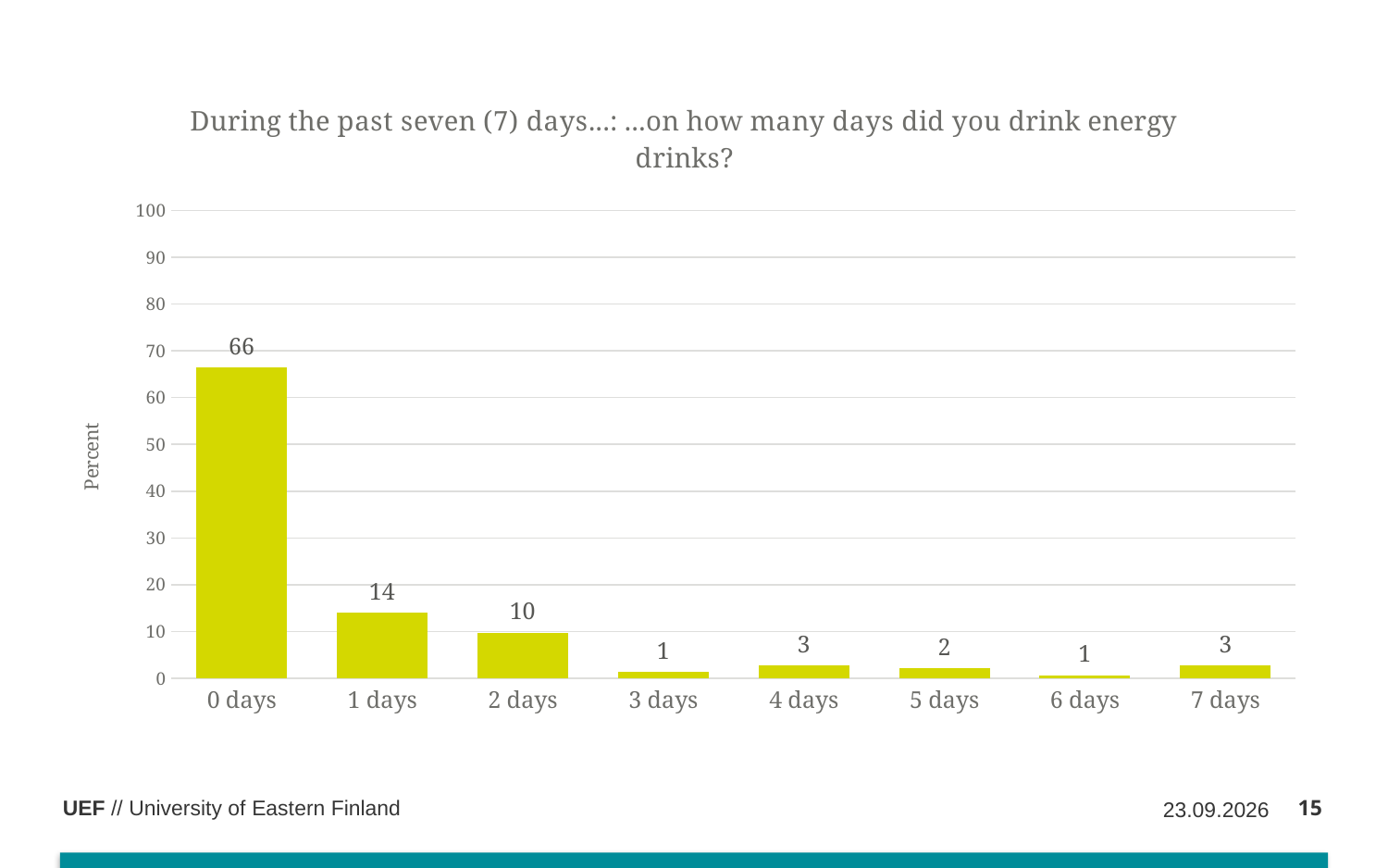
How many categories are shown on the x axis? 8 What is the label of the y axis? Percent What is the value for 4 days? 3 What is the value for 0 days? 66 What is the value for 2 days? 10 Which category has the highest value? 0 days Which is larger, the value for 2 days or the value for 5 days? 2 days What is the difference between the values for 0 days and 1 days? 52 Is the value for 0 days greater or less than 60? greater What is the difference between the values for 1 days and 2 days? 4 What kind of chart is this? bar chart What is the value for 1 days? 14